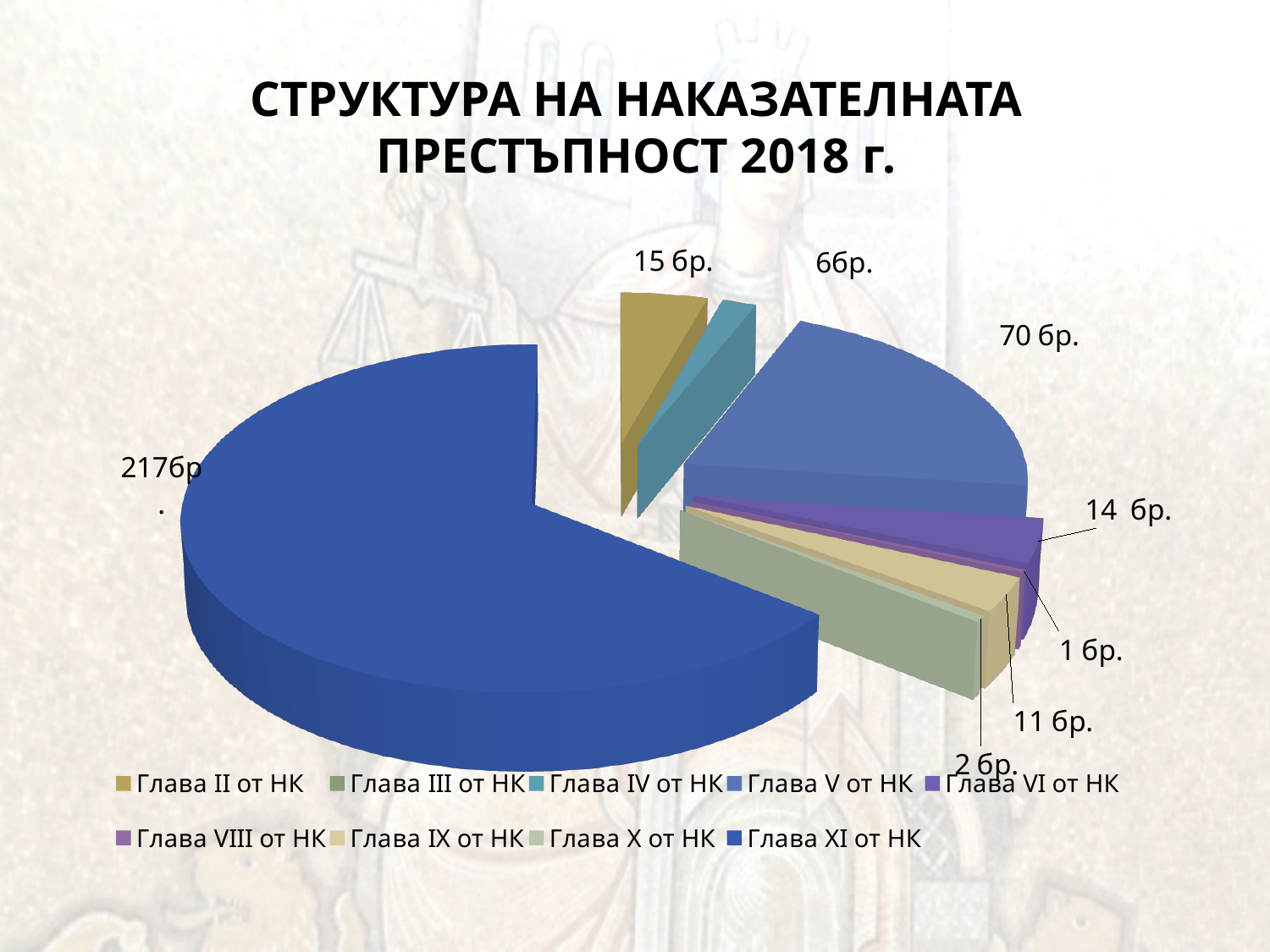
Which category has the smallest labelled slice of the pie? Глава VIII от НК What is the value shown for Глава II от НК? 15 бр. What is the difference between the values for Глава XI от НК and Глава V от НК? 147 How many entries does the legend list? 9 What kind of chart is shown on the slide? Pie chart What is the value shown for Глава IV от НК? 6бр. Which is larger, the value for Глава V от НК or the value for Глава II от НК? Глава V от НК What is the value shown for Глава V от НК? 70 бр. What is the value shown for Глава VI от НК? 14 бр. Which category has the largest slice of the pie? Глава XI от НК What is the title of the chart? СТРУКТУРА НА НАКАЗАТЕЛНАТА ПРЕСТЪПНОСТ 2018 г. What is the value shown for Глава XI от НК? 217бр.